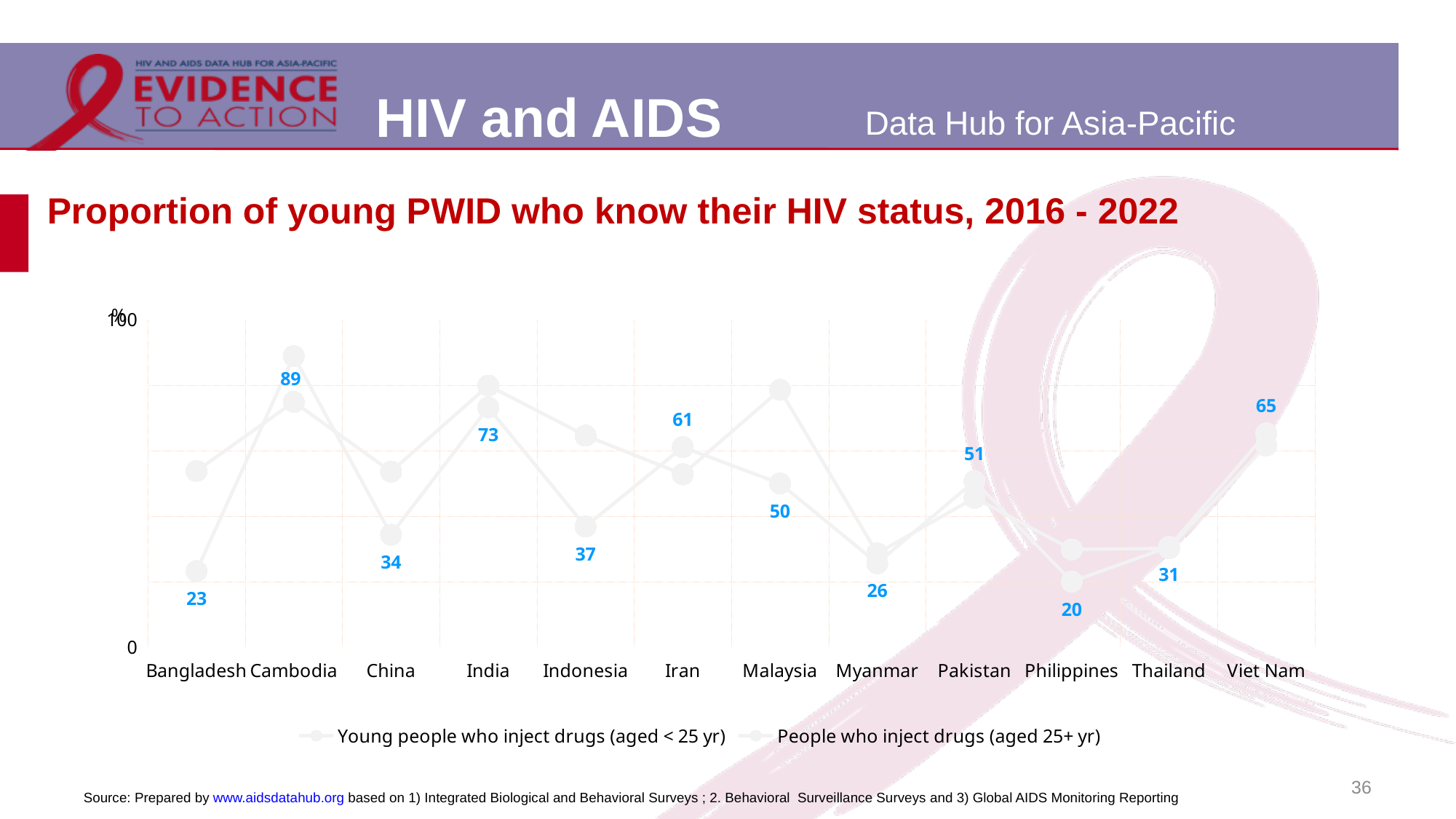
Which has the larger labelled value, Iran or Malaysia? Iran What is the title of the chart? Proportion of young PWID who know their HIV status, 2016 - 2022 How many series does the chart legend list? 2 What is the difference between the labelled values for Cambodia and the Philippines? 69 Which country has the lowest labelled value on the chart? Philippines Which country has the highest labelled value on the chart? Cambodia What is the labelled value for Cambodia? 89 What is the labelled value for Viet Nam? 65 What kind of chart is shown on the slide? line chart How many countries are shown on the x axis of the chart? 12 What is the first series listed in the chart legend? Young people who inject drugs (aged < 25 yr) What is the labelled value for Myanmar? 26